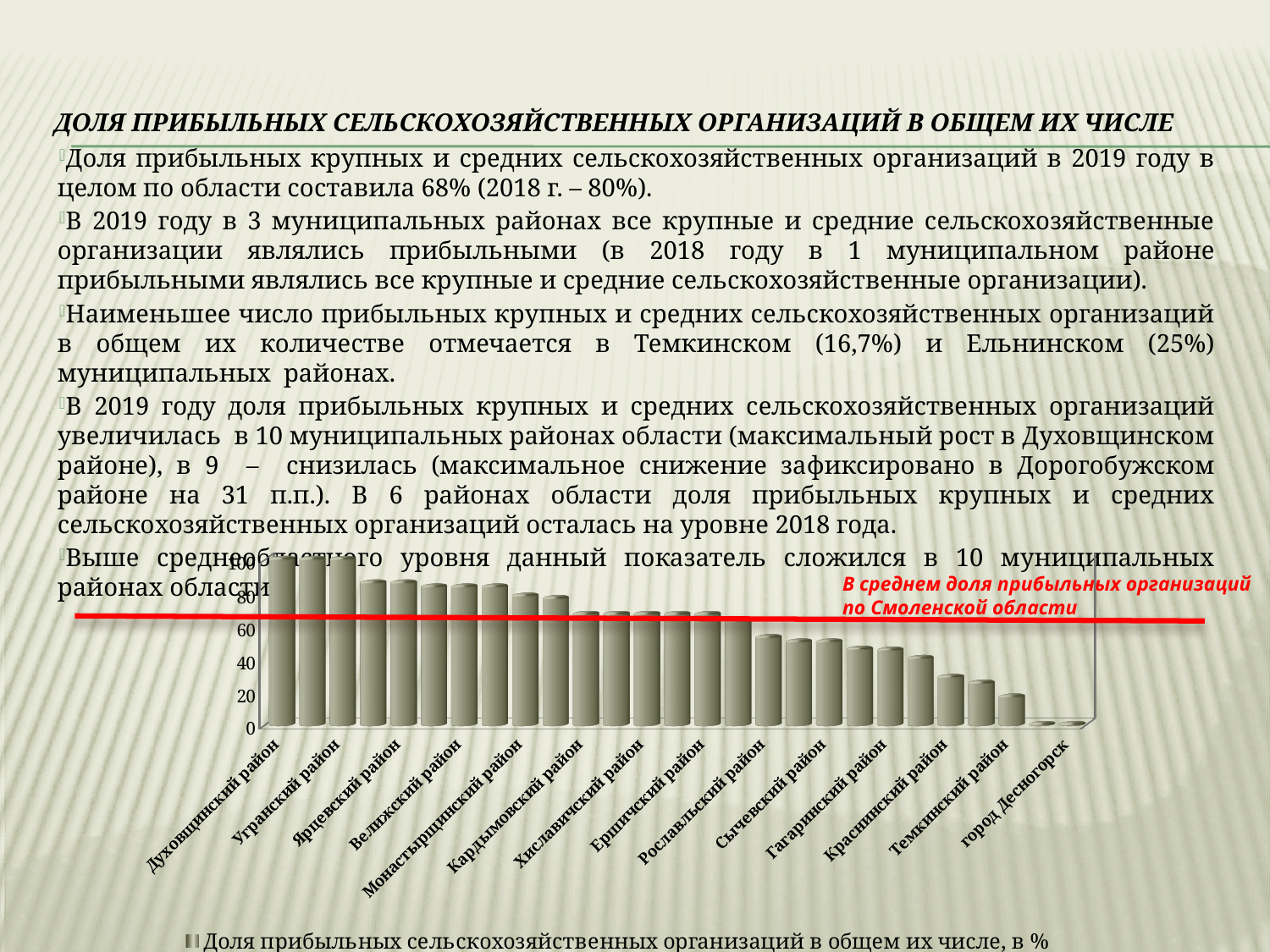
Is the value for Гагаринский район greater or less than 60? less Do the values on the chart rise or fall from left to right along the x axis? fall Which has the larger value, Ярцевский район or Гагаринский район? Ярцевский район Is the value for Темкинский район greater or less than 20? less Is the value for Ярцевский район greater or less than 80? greater How many series does the chart legend list? 1 Which has the larger value, Духовщинский район or Темкинский район? Духовщинский район What is the legend entry of the chart? Доля прибыльных сельскохозяйственных организаций в общем их числе, в % What does the red horizontal line on the chart represent? В среднем доля прибыльных организаций по Смоленской области What kind of chart is shown on the slide? bar chart